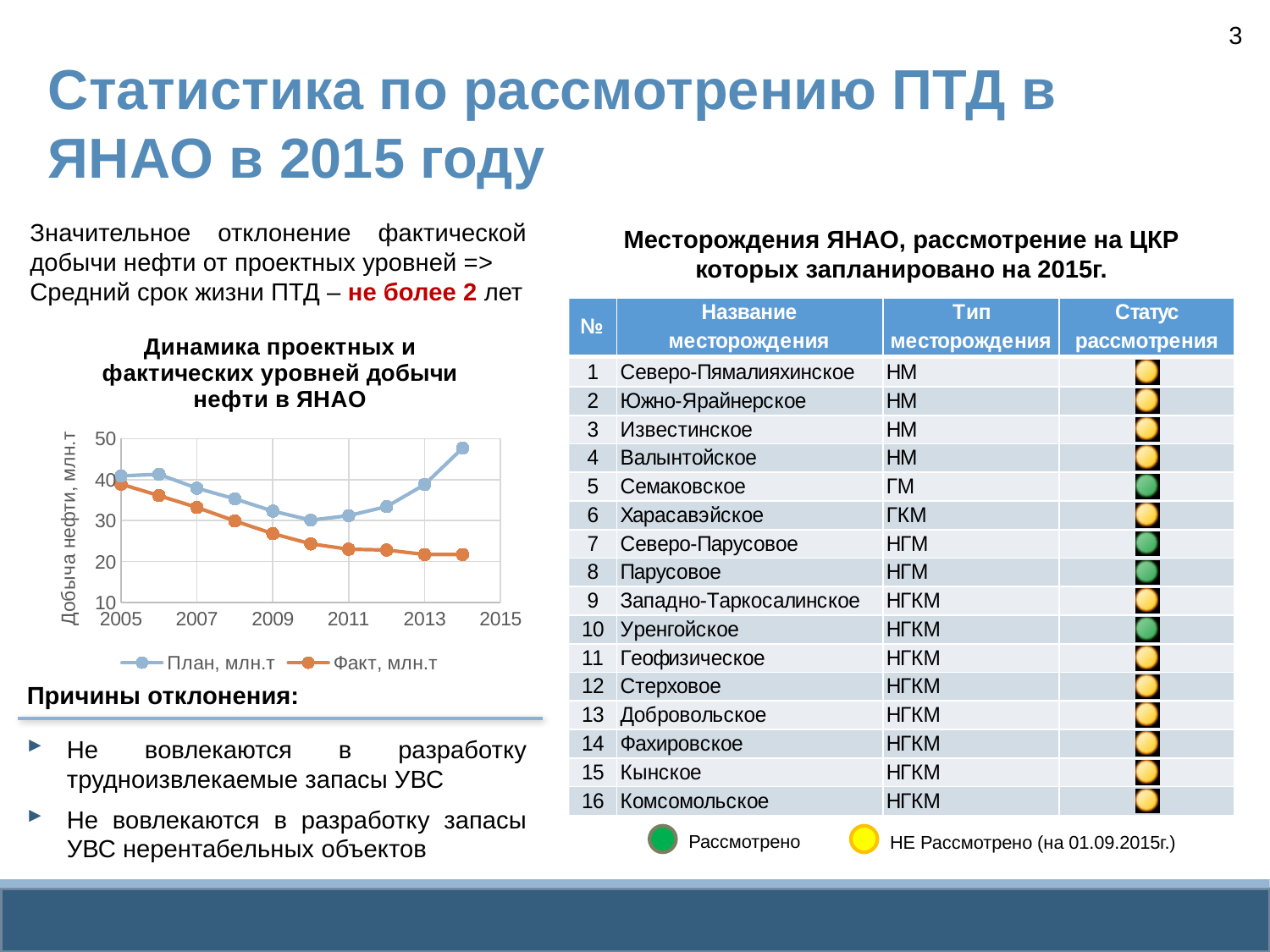
In 2014, which series has the larger value, План, млн.т or Факт, млн.т? План, млн.т What kind of chart is shown on the slide? line chart Is the value of Факт, млн.т in 2014 greater or less than 30? less What are the two series named in the chart legend? План, млн.т and Факт, млн.т What is the label of the vertical axis of the chart? Добыча нефти, млн.т How many series does the chart legend list? 2 How many data points does the Факт, млн.т series have? 10 In which year does the План, млн.т series reach its highest value? 2014 Does the Факт, млн.т series rise or fall from 2005 to 2014? fall Is the value of Факт, млн.т in 2010 greater or less than 30? less Is the value of План, млн.т in 2014 greater or less than 40? greater